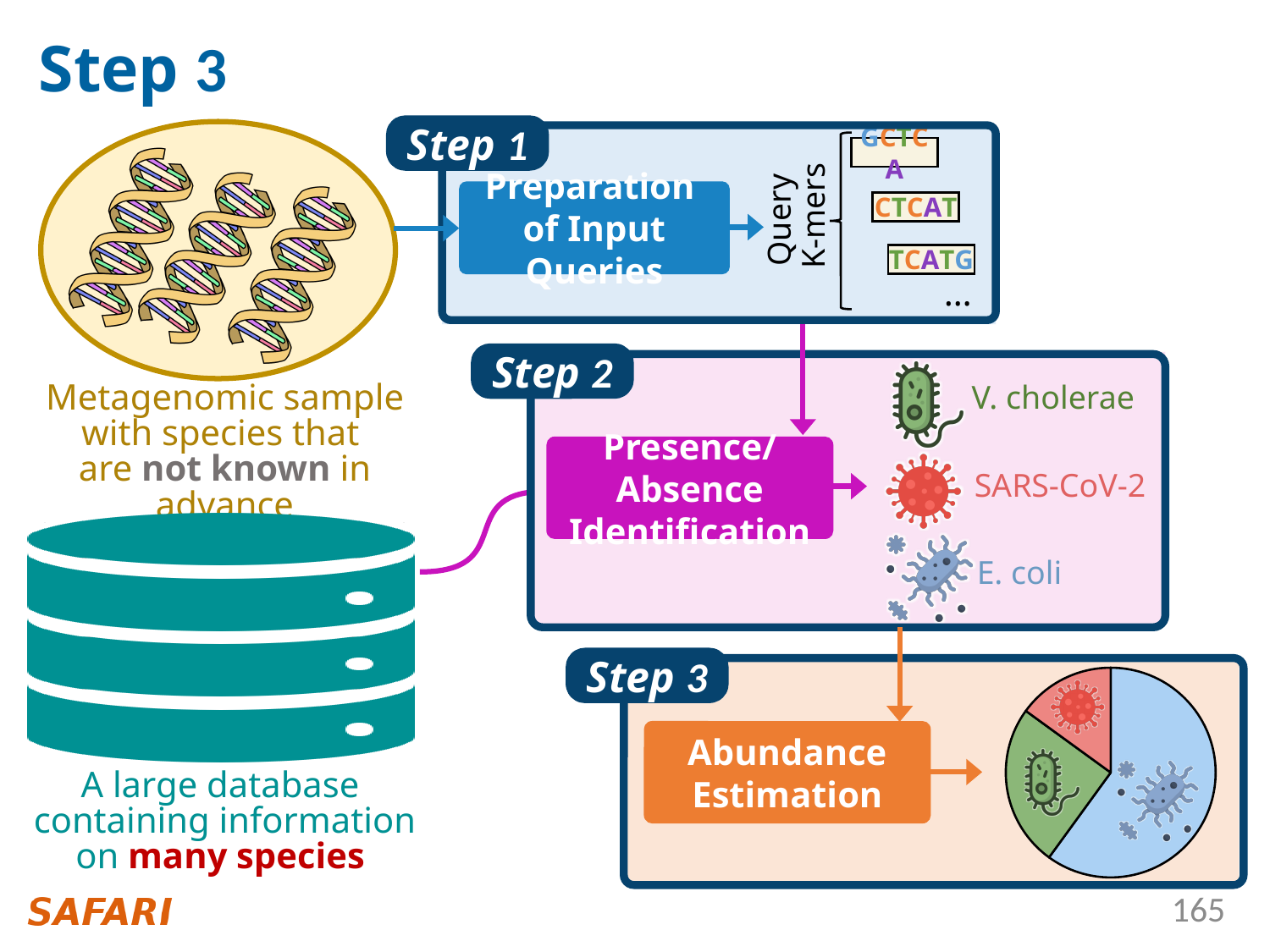
How many slices does the pie chart in the Step 3 box have? 3 In the Step 3 pie chart, which slice is the smallest? the red slice (SARS-CoV-2) Which process box feeds into the pie chart in Step 3? Abundance Estimation What three colours are used for the slices of the Step 3 pie chart? red, green and blue In the Step 3 pie chart, is the blue (E. coli) slice larger or smaller than the red (SARS-CoV-2) slice? larger Does the largest slice of the Step 3 pie chart take up more or less than half of the pie? more In the Step 3 pie chart, which slice is the largest? the blue slice (E. coli) What kind of chart is shown in the Step 3 box? pie chart In the Step 3 pie chart, is the green (V. cholerae) slice larger or smaller than the blue (E. coli) slice? smaller